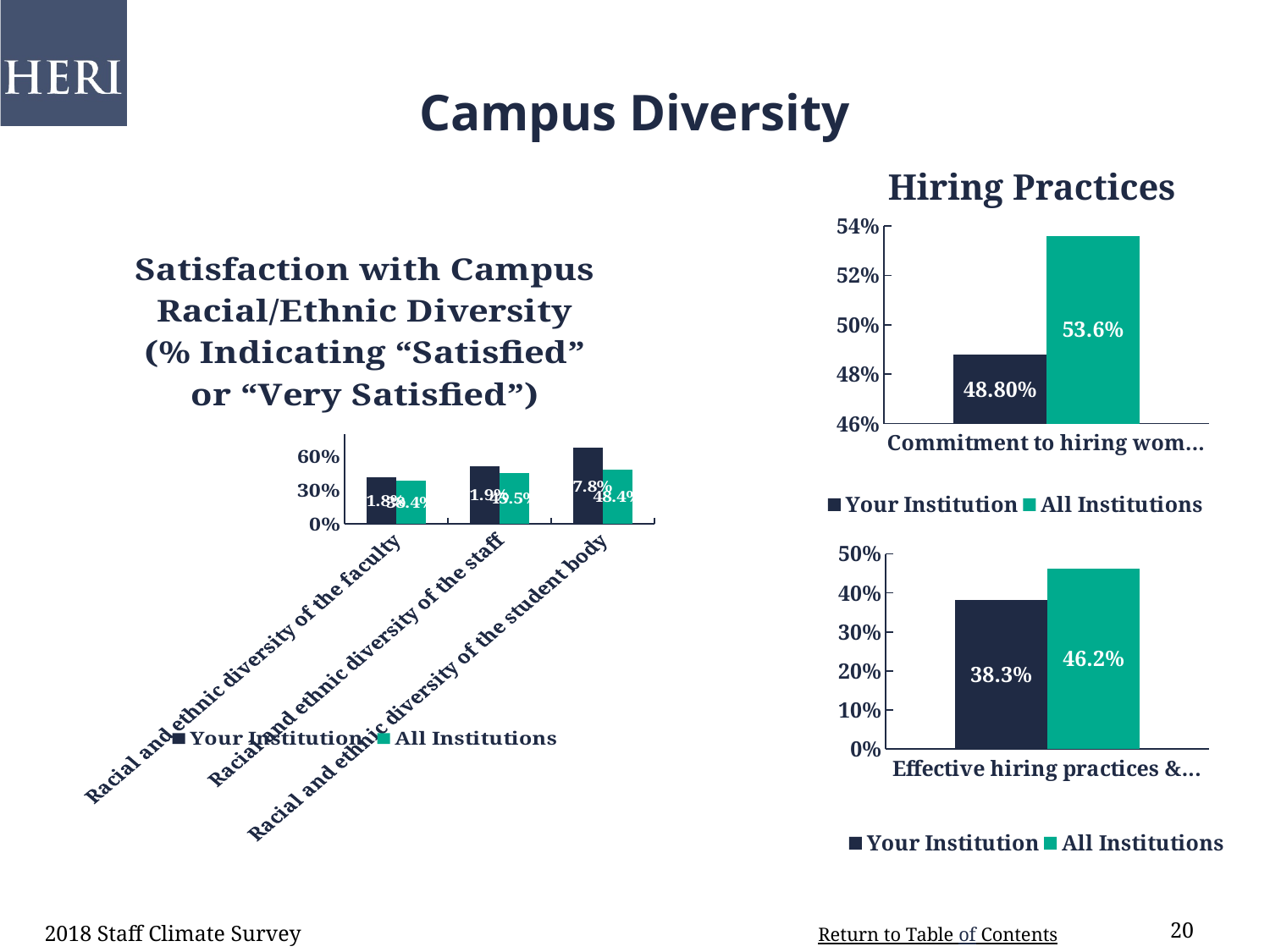
How many categories are shown in the Satisfaction with Campus Racial/Ethnic Diversity chart on the left? 3 In the bottom-right chart (Effective hiring practices), what is the value for Your Institution? 38.3% In the Hiring Practices chart (top right), what is the difference between All Institutions and Your Institution? 4.8 percentage points In the Hiring Practices chart (top right), which is larger, Your Institution or All Institutions? All Institutions In the Satisfaction with Campus Racial/Ethnic Diversity chart on the left, what is the All Institutions value for racial and ethnic diversity of the student body? 48.4% What kind of chart is the Satisfaction with Campus Racial/Ethnic Diversity chart on the left? Bar chart In the bottom-right chart (Effective hiring practices), what is the value for All Institutions? 46.2% In the bottom-right chart (Effective hiring practices), what is the difference between All Institutions and Your Institution? 7.9 percentage points In the Hiring Practices chart (top right), what is the value for All Institutions? 53.6% In the Hiring Practices chart (top right), what is the value for Your Institution? 48.80% In the Satisfaction with Campus Racial/Ethnic Diversity chart on the left, is the Your Institution value for racial and ethnic diversity of the student body greater or less than 60%? greater How many series does the legend list in the Satisfaction with Campus Racial/Ethnic Diversity chart on the left? 2